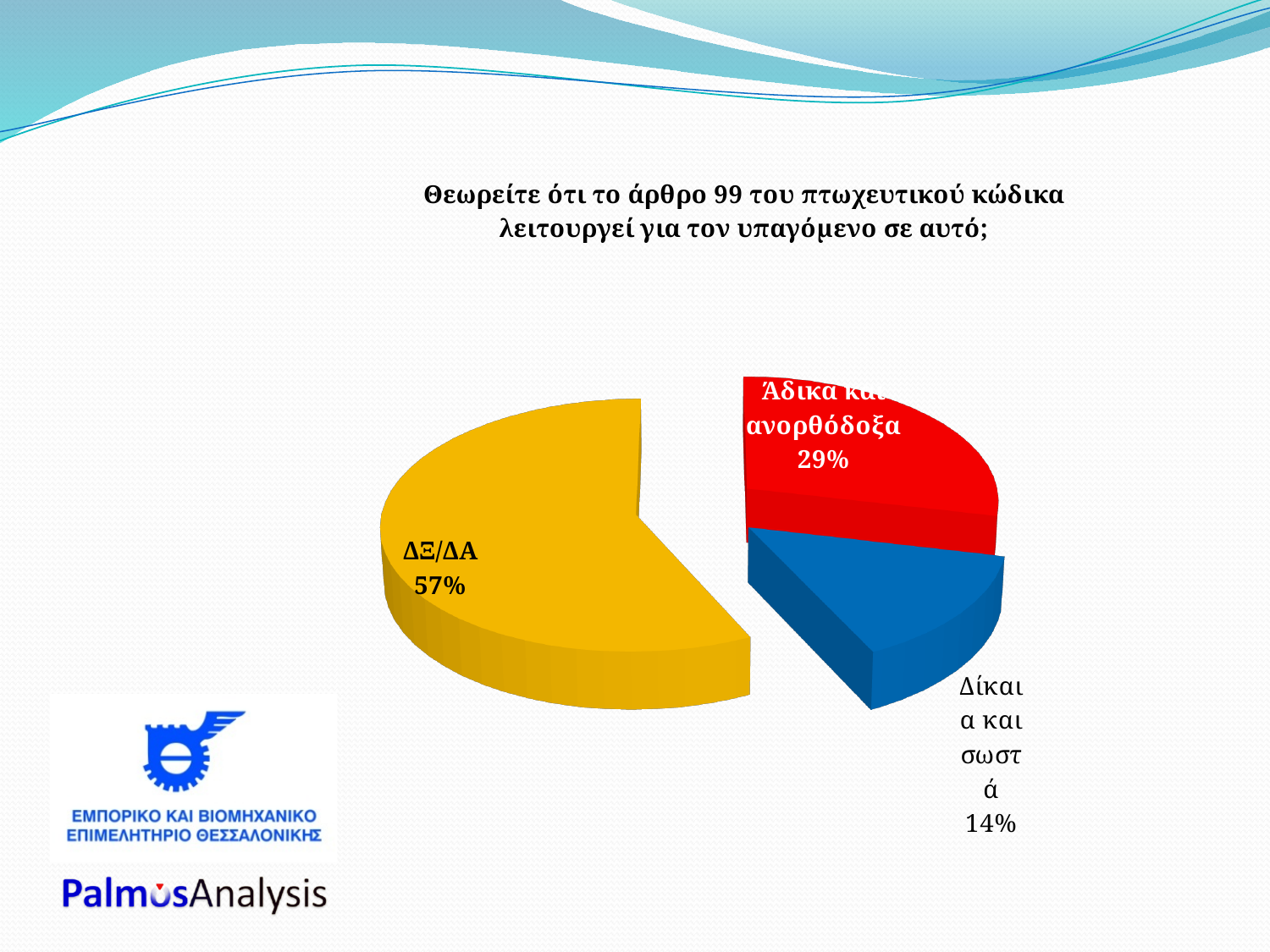
What percentage of respondents answered Άδικα και ανορθόδοξα? 29% What colour is the slice for ΔΞ/ΔΑ? Yellow What is the difference in percentage points between ΔΞ/ΔΑ and Άδικα και ανορθόδοξα? 28 What is the difference in percentage points between Άδικα και ανορθόδοξα and Δίκαια και σωστά? 15 Which response has the largest share of the pie? ΔΞ/ΔΑ Which is larger, the share for Άδικα και ανορθόδοξα or the share for Δίκαια και σωστά? Άδικα και ανορθόδοξα What percentage of respondents answered ΔΞ/ΔΑ? 57% Which response has the smallest share of the pie? Δίκαια και σωστά How many slices does the pie chart have? 3 What kind of chart is shown on the slide? Pie chart What percentage of respondents answered Δίκαια και σωστά? 14% What colour is the slice for Δίκαια και σωστά? Blue